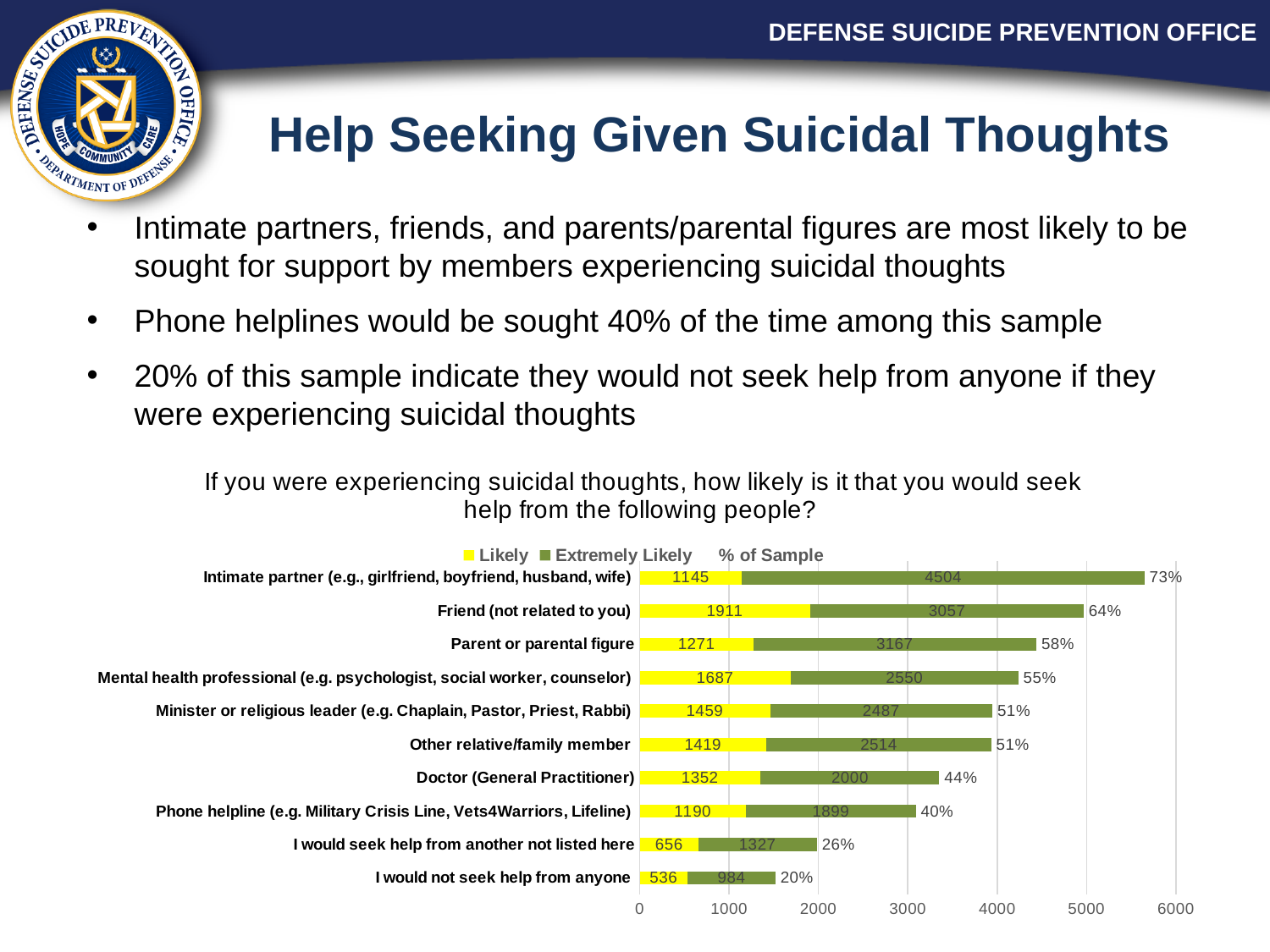
What is the Extremely Likely value for Intimate partner? 4504 What type of chart is shown on the slide? Stacked bar chart Which category has the lowest Likely value? I would not seek help from anyone What is the Likely value for Friend (not related to you)? 1911 What is the difference between the Extremely Likely values for Intimate partner and Friend? 1447 Which series is shown in yellow in the chart? Likely How many categories (people/sources of help) are listed on the chart? 10 How many entries does the chart legend list? 3 Which category has the highest Extremely Likely value? Intimate partner (e.g., girlfriend, boyfriend, husband, wife) What is the total of the stacked bar for I would not seek help from anyone? 1520 What percentage of the sample is shown for Phone helpline? 40% Which has a larger Likely value: Mental health professional or Doctor (General Practitioner)? Mental health professional